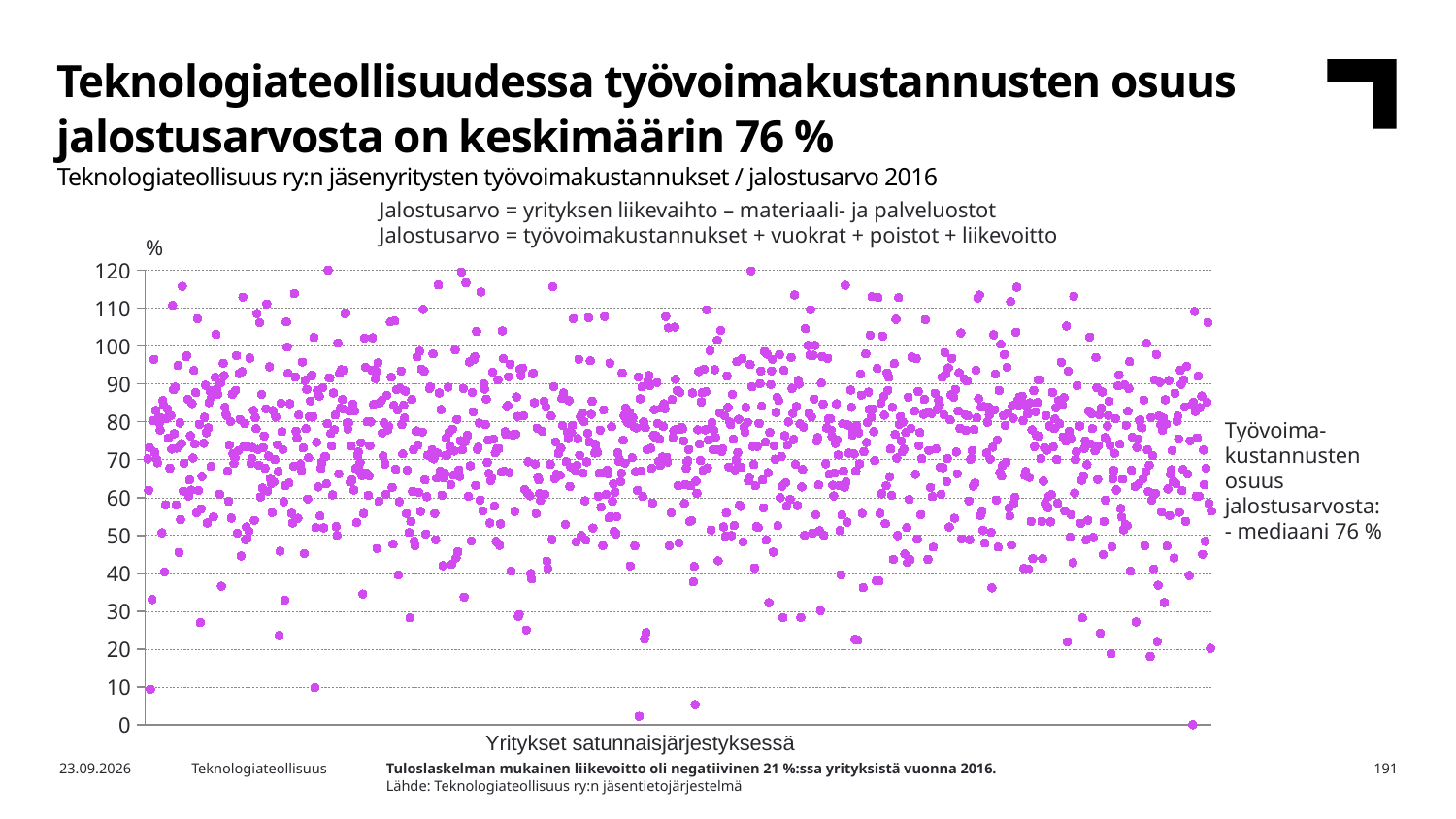
What is the highest value shown on the vertical axis of the chart? 120 Which year does the chart's data refer to? 2016 Is the median value of 76 % stated on the slide greater or less than 70 on the vertical axis? greater According to the footnote, in what percentage of companies was the operating profit negative in 2016? 21 % What unit is shown at the top of the vertical axis? % What is the lowest value shown on the vertical axis of the chart? 0 What is the label of the horizontal axis of the chart? Yritykset satunnaisjärjestyksessä What kind of chart is shown on the slide? Scatter plot What is the interval between the gridline ticks on the vertical axis? 10 What is the median share of labour costs in value added stated next to the chart? 76 % According to the slide title, what is the average share of labour costs in value added in the technology industry? 76 %